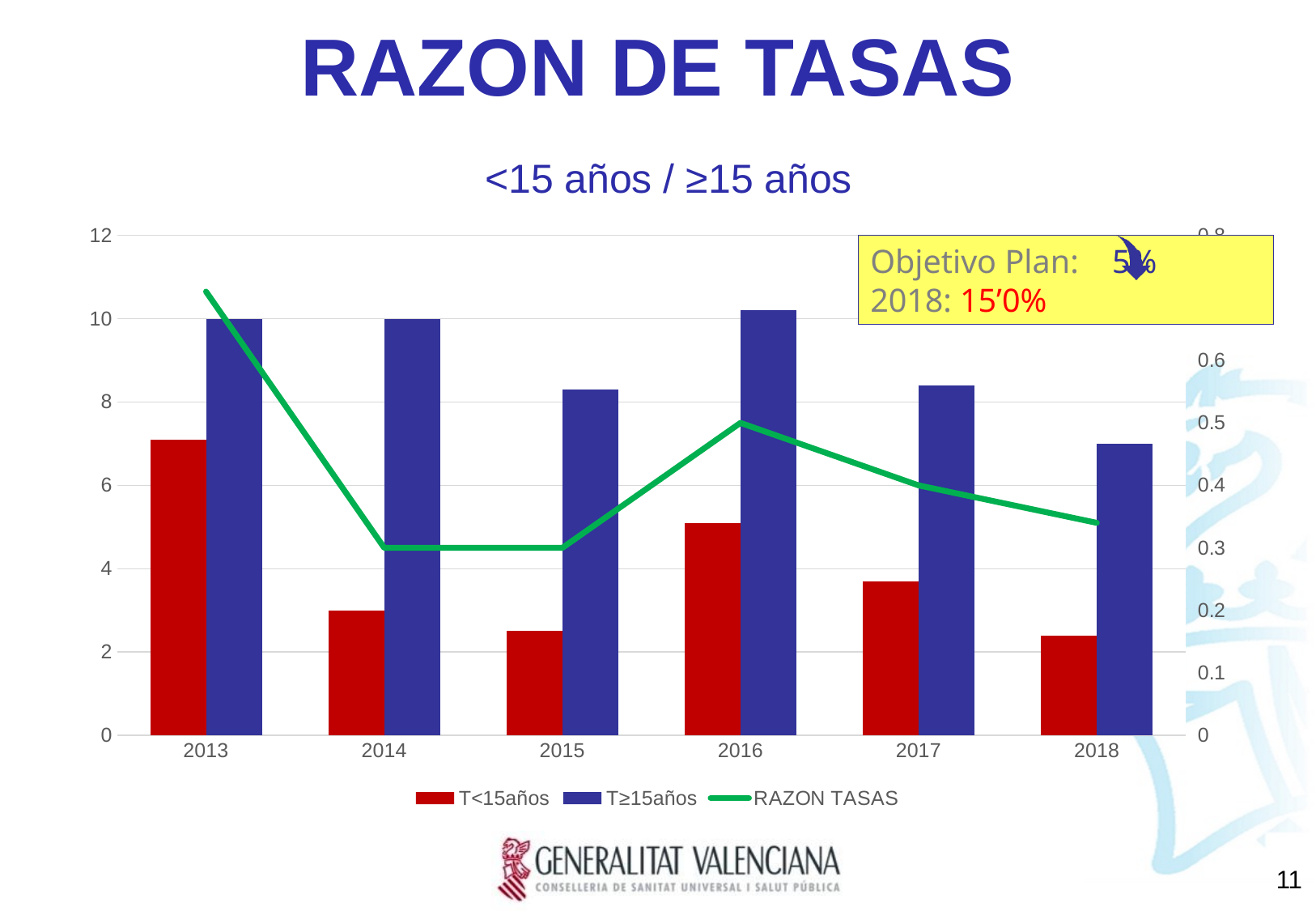
Does the RAZON TASAS line rise or fall from 2016 to 2018? Falls Is the RAZON TASAS value for 2016 greater or less than 0.4? greater In which year is the T≥15años bar lowest? 2018 In which year does the RAZON TASAS line reach its highest value? 2013 Is the value for T≥15años in 2018 greater or less than 8? less What kind of chart is shown on the slide? Bar chart with a line series In which year is the T<15años bar highest? 2013 How many series does the chart legend list? 3 How many years are shown on the x axis of the chart? 6 What colour is the RAZON TASAS line in the chart? Green Is the value for T<15años in 2013 greater or less than 6? greater Which is larger, the T<15años bar for 2013 or for 2016? 2013